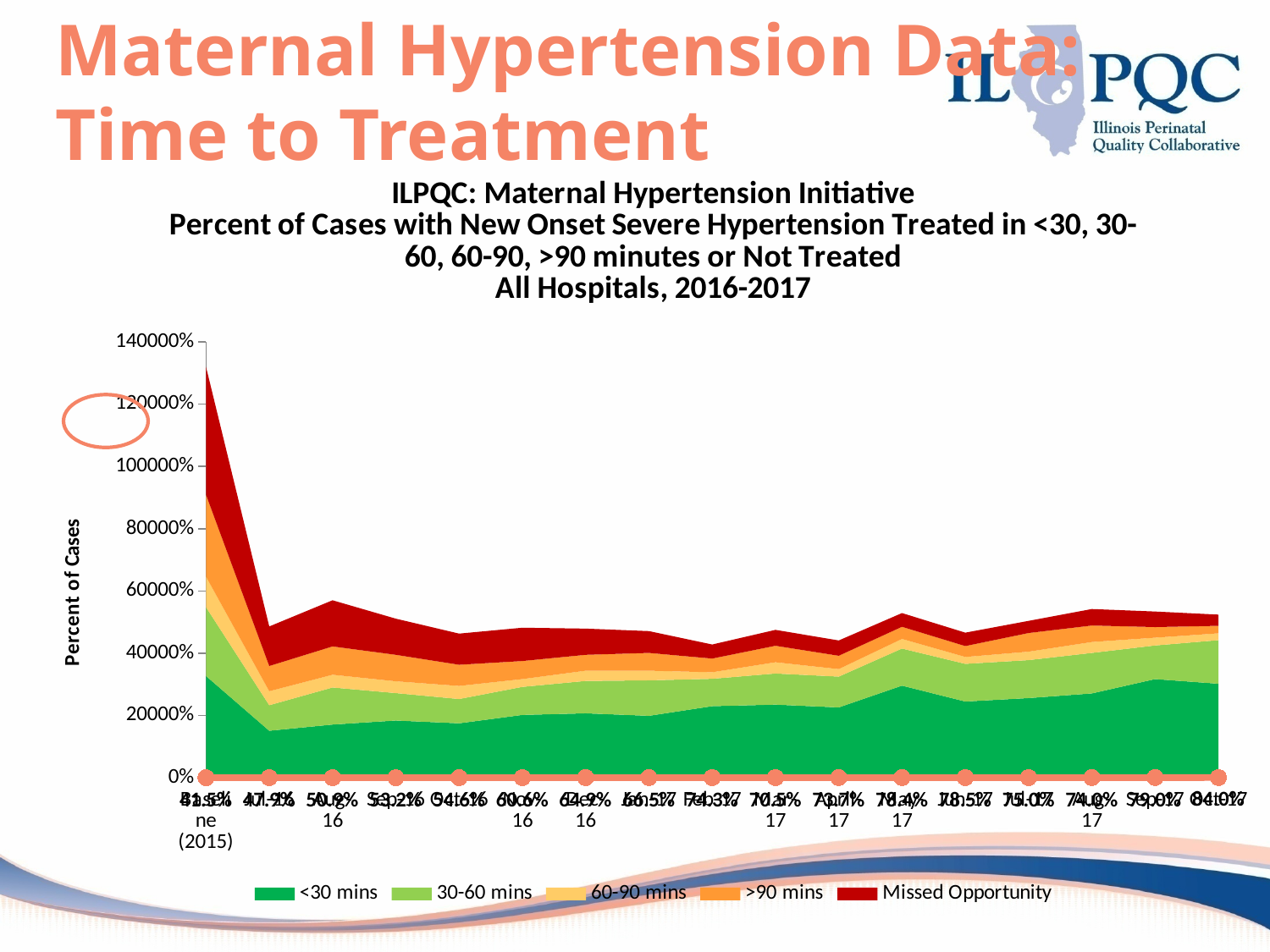
What is the highest tick value shown on the vertical axis? 140000% What is the label on the vertical axis of the chart? Percent of Cases At which point along the x axis is the total stacked value highest? The first point Is the total stacked value at the first point larger or smaller than at the last point? larger How many series does the chart's legend list? 5 Is the total stacked value at the second point on the x axis greater or less than 60000%? less Is the total stacked value at the first point on the x axis greater or less than 100000%? greater Does the total stacked value rise or fall between the first and second points on the x axis? fall Which series is shown in red at the top of the stacked areas? Missed Opportunity What kind of chart is shown on the slide? Stacked area chart